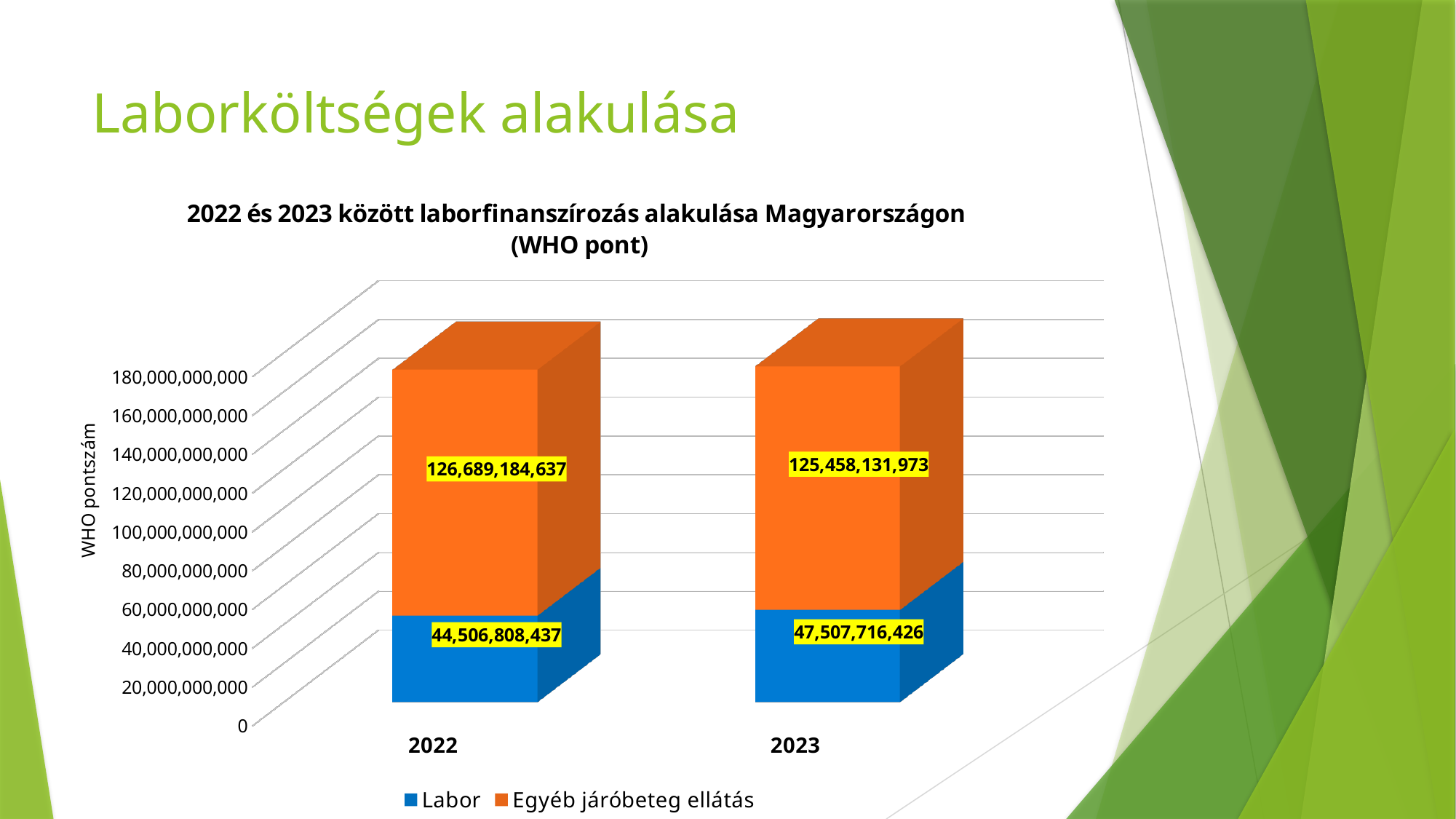
What is the value for Egyéb járóbeteg ellátás in 2023? 125,458,131,973 What is the value for Egyéb járóbeteg ellátás in 2022? 126,689,184,637 What is the difference between the Egyéb járóbeteg ellátás values for 2022 and 2023? 1,231,052,664 By how much did the Labor value increase from 2022 to 2023? 3,000,907,989 In which year is the Egyéb járóbeteg ellátás value lower? 2023 How many series does the legend list? 2 What is the total of the stacked bar for 2022? 171,195,993,074 In which year is the Labor value higher? 2023 What is the total of the stacked bar for 2023? 172,965,848,399 What is the value for Labor in 2022? 44,506,808,437 What kind of chart is shown on the slide? Stacked bar chart What is the value for Labor in 2023? 47,507,716,426